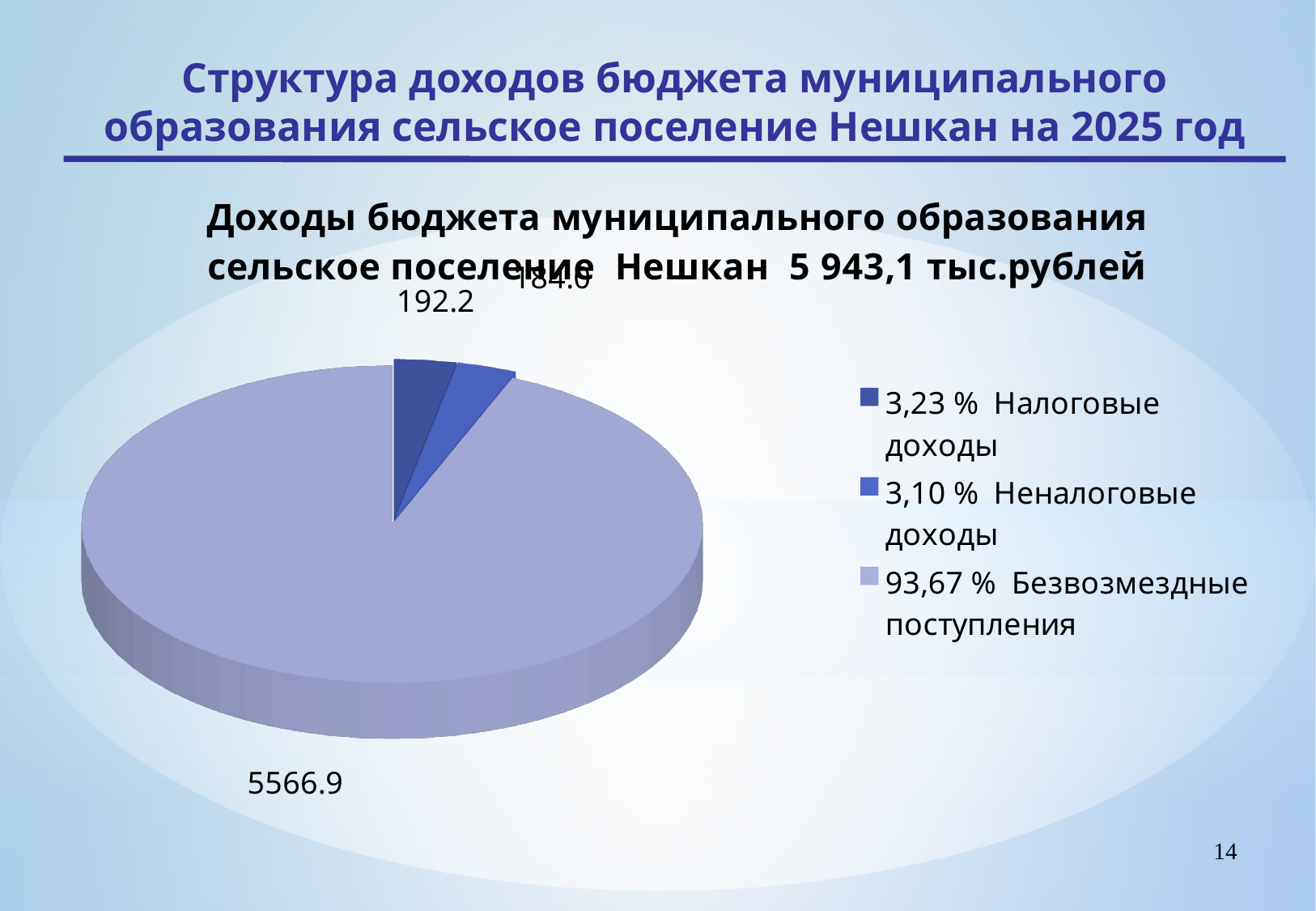
How many entries does the legend list? 3 How many slices does the pie chart have? 3 What share of the pie does Неналоговые доходы represent, according to the legend? 3,10 % What share of the pie does Налоговые доходы represent, according to the legend? 3,23 % Which is larger, the value for Безвозмездные поступления or the value for Налоговые доходы? Безвозмездные поступления What total amount of budget revenue is stated in the chart title? 5 943,1 тыс.рублей What is the value shown for Безвозмездные поступления? 5566.9 What is the difference between the value for Безвозмездные поступления and the value for Налоговые доходы? 5374.7 What kind of chart is shown on the slide? pie chart What is the value shown for Налоговые доходы? 192.2 Which category has the largest slice of the pie? Безвозмездные поступления What share of the pie does Безвозмездные поступления represent, according to the legend? 93,67 %